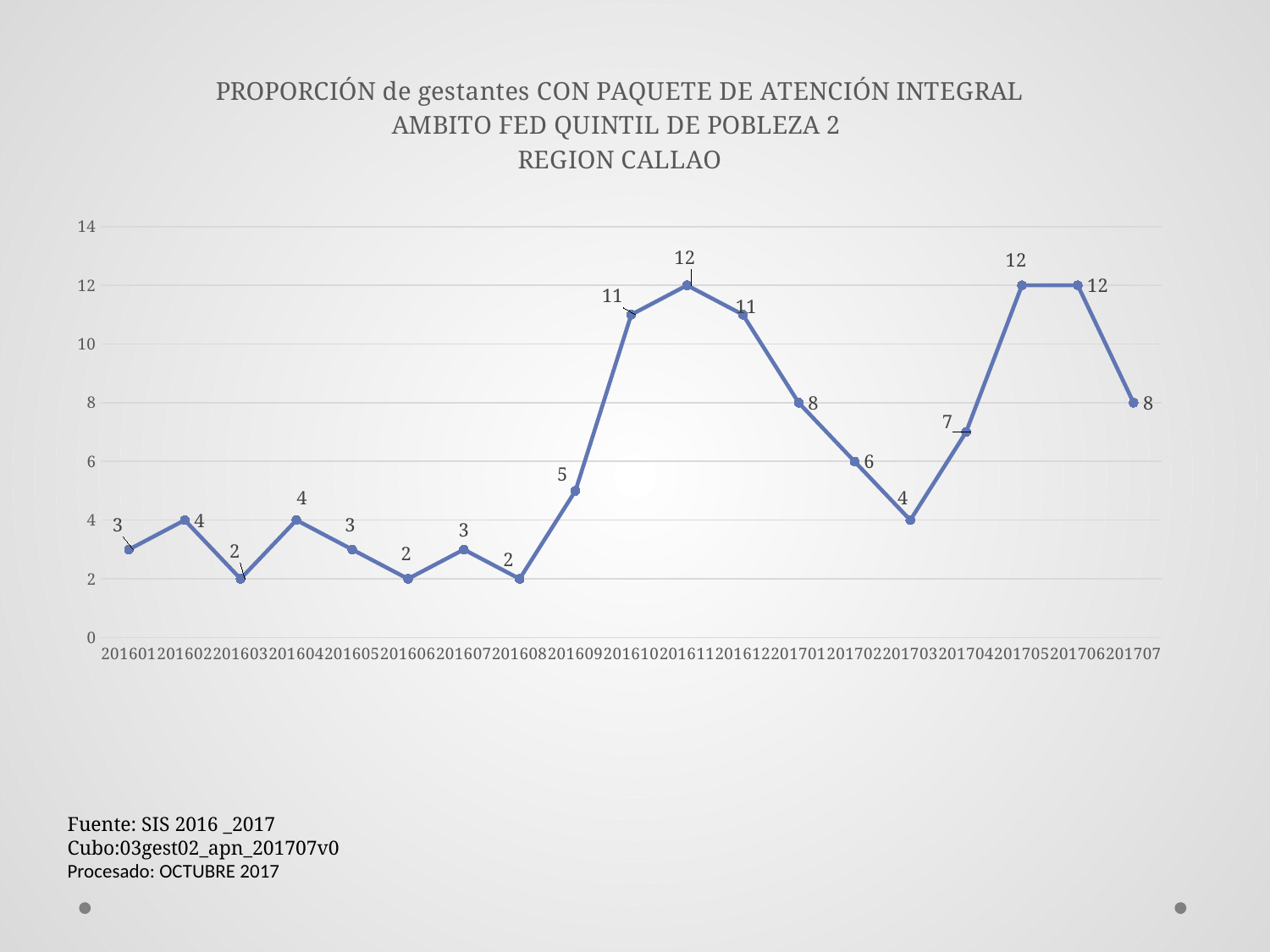
How many data points are plotted on the chart? 19 What is the highest value plotted on the chart? 12 What is the value for 201704? 7 What is the value for 201701? 8 What is the value for 201610? 11 Does the value rise or fall from 201706 to 201707? fall Which region is named in the chart title? REGION CALLAO What type of chart is shown on the slide? line chart What is the difference between the values for 201611 and 201703? 8 What is the value for 201609? 5 What is the lowest value plotted on the chart? 2 Which has a larger value, 201702 or 201704? 201704